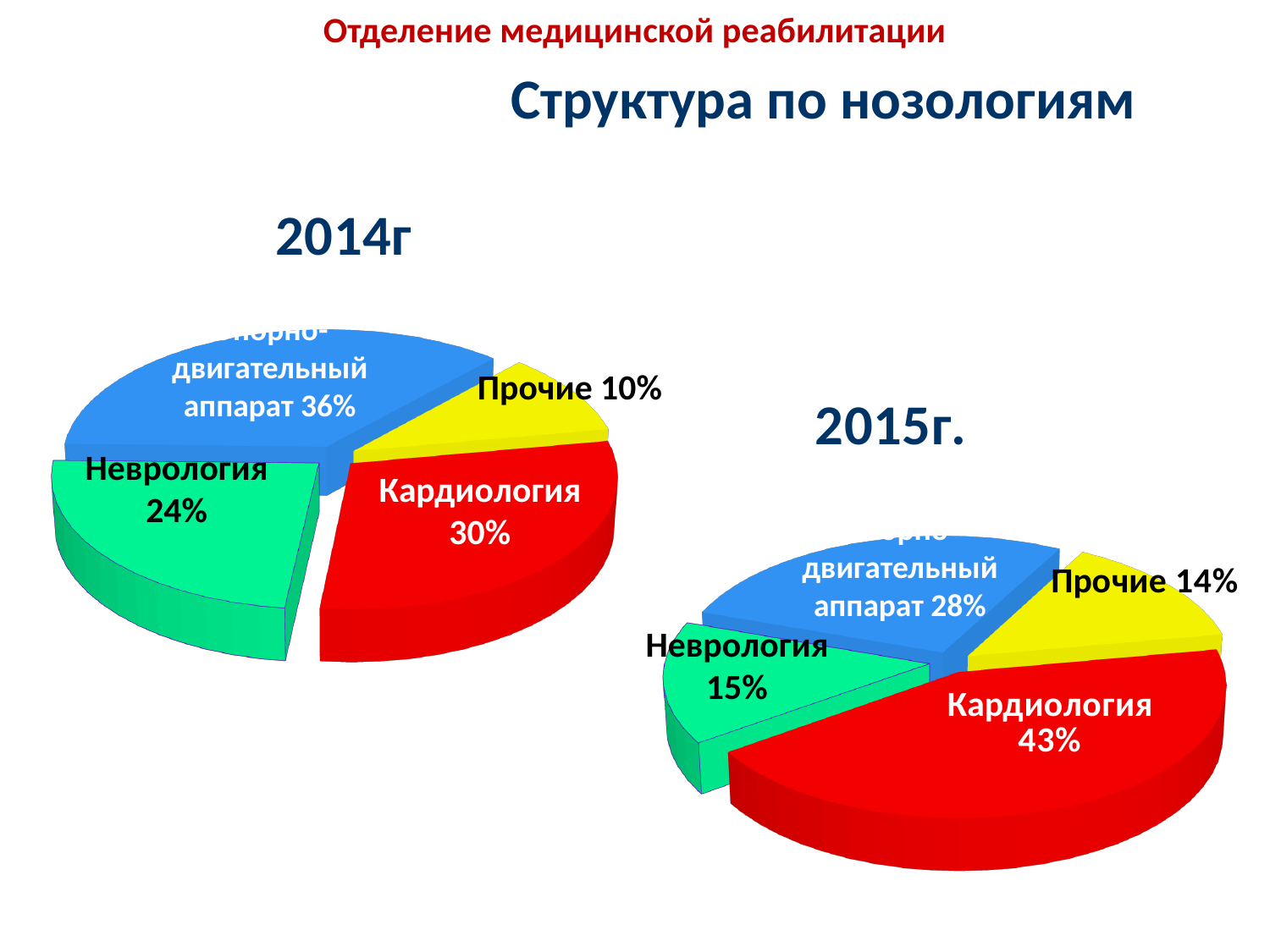
In the 2014г chart, what share does Неврология have? 24% In the 2014г chart, which category has the smallest share? Прочие In the 2015г. chart, what share does Опорно-двигательный аппарат have? 28% In the 2015г. chart, which category has the largest share? Кардиология In the 2015г. chart, which category has the smallest share? Прочие In the 2015г. chart, what share does Кардиология have? 43% How many slices does the 2015г. pie chart have? 4 In the 2014г chart, what share does Кардиология have? 30% In the 2015г. chart, what is the difference between the shares of Кардиология and Неврология? 28% What type of chart is used for the 2014г chart? pie chart In the 2014г chart, which category has the largest share? Опорно-двигательный аппарат In the 2014г chart, what share does Прочие have? 10%